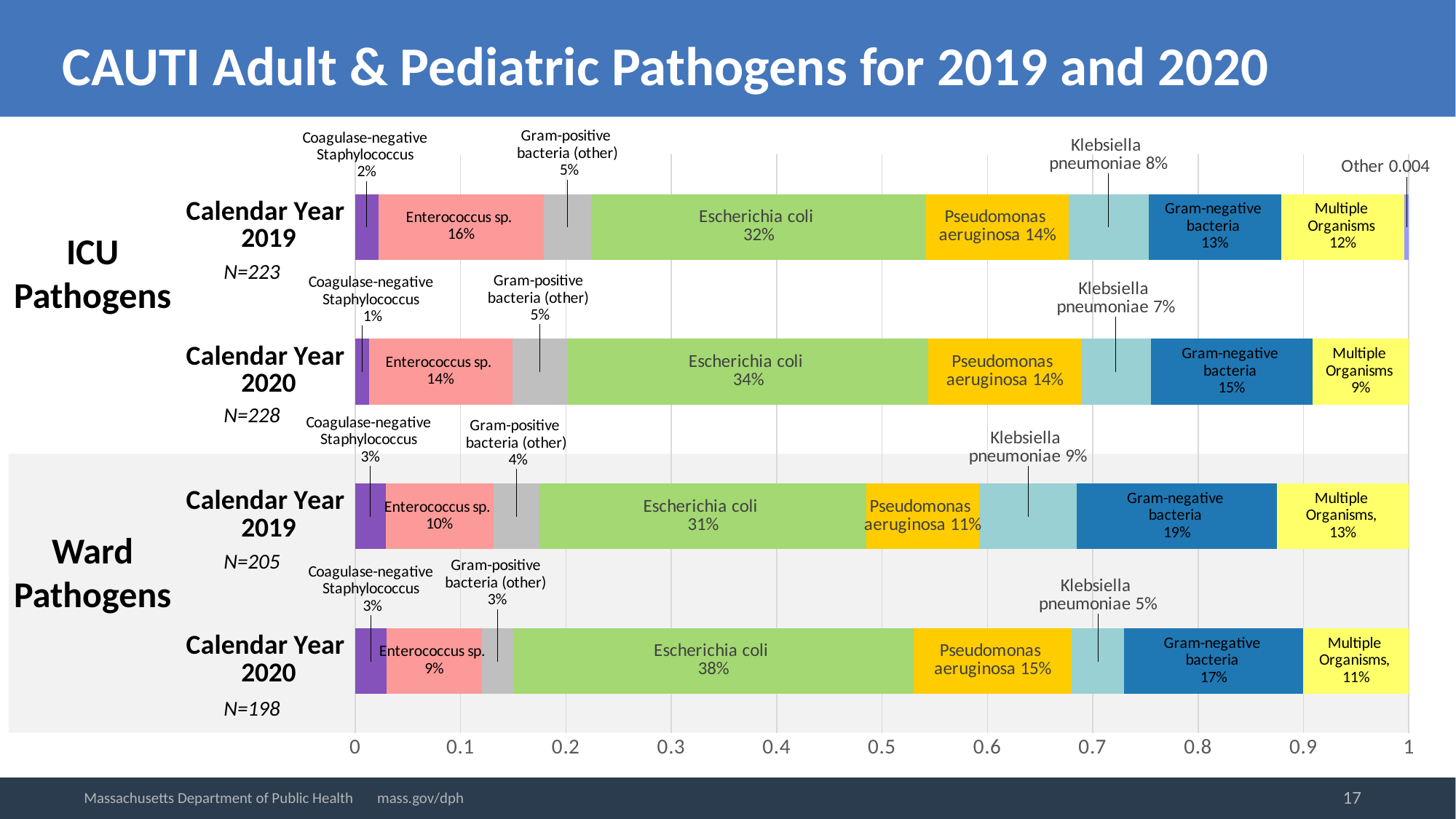
What percentage of Ward pathogens in Calendar Year 2020 was Escherichia coli? 38% What is the difference between the Gram-negative bacteria percentage for Ward Pathogens 2019 and ICU Pathogens 2019? 6 percentage points What percentage of ICU pathogens in Calendar Year 2020 was Klebsiella pneumoniae? 7% What percentage of ICU pathogens in Calendar Year 2019 was Escherichia coli? 32% What kind of chart is shown on the slide? Stacked bar chart What value is shown for the 'Other' category in ICU Pathogens Calendar Year 2019? 0.004 How many stacked bars are shown in the chart? 4 What is the title of the slide? CAUTI Adult & Pediatric Pathogens for 2019 and 2020 Which bar has the lowest Coagulase-negative Staphylococcus percentage? ICU Pathogens, Calendar Year 2020 Which is larger: the Enterococcus sp. percentage for ICU Pathogens 2019 or for Ward Pathogens 2019? ICU Pathogens 2019 Which of the four bars has the highest Escherichia coli percentage? Ward Pathogens, Calendar Year 2020 What is the N value for Ward Pathogens in Calendar Year 2020? N=198